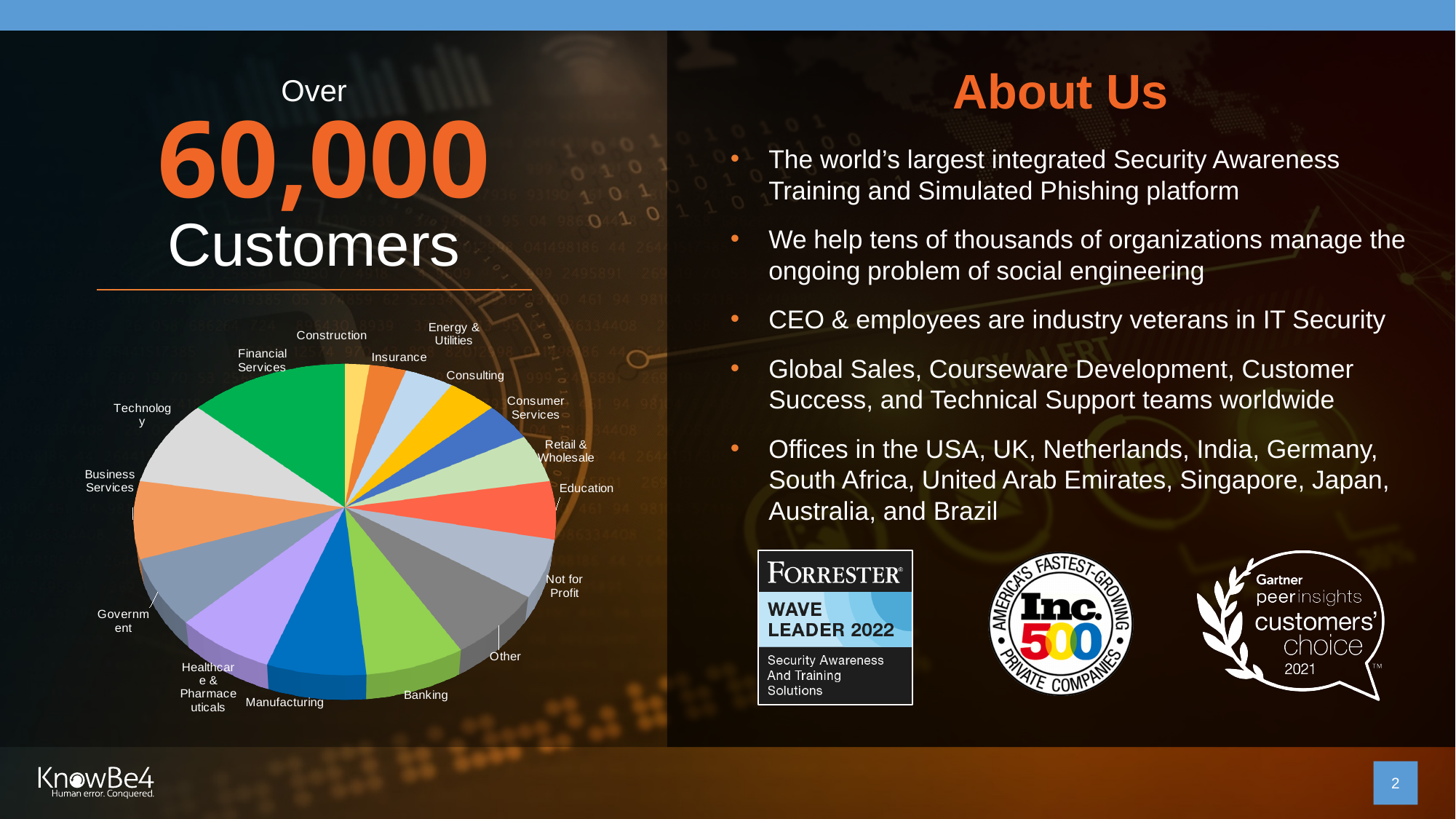
What number of customers is stated above the pie chart? Over 60,000 Which slice is larger on the pie chart, Financial Services or Construction? Financial Services Which industry category has the largest slice of the pie chart? Financial Services Which slice is larger on the pie chart, Technology or Insurance? Technology Which slice is larger on the pie chart, Banking or Energy & Utilities? Banking Which industry category has the smallest slice of the pie chart? Construction What kind of chart is shown on the left side of the slide under the '60,000 Customers' heading? Pie chart What colour is the Financial Services slice of the pie chart? Green How many industry categories are labelled on the pie chart? 16